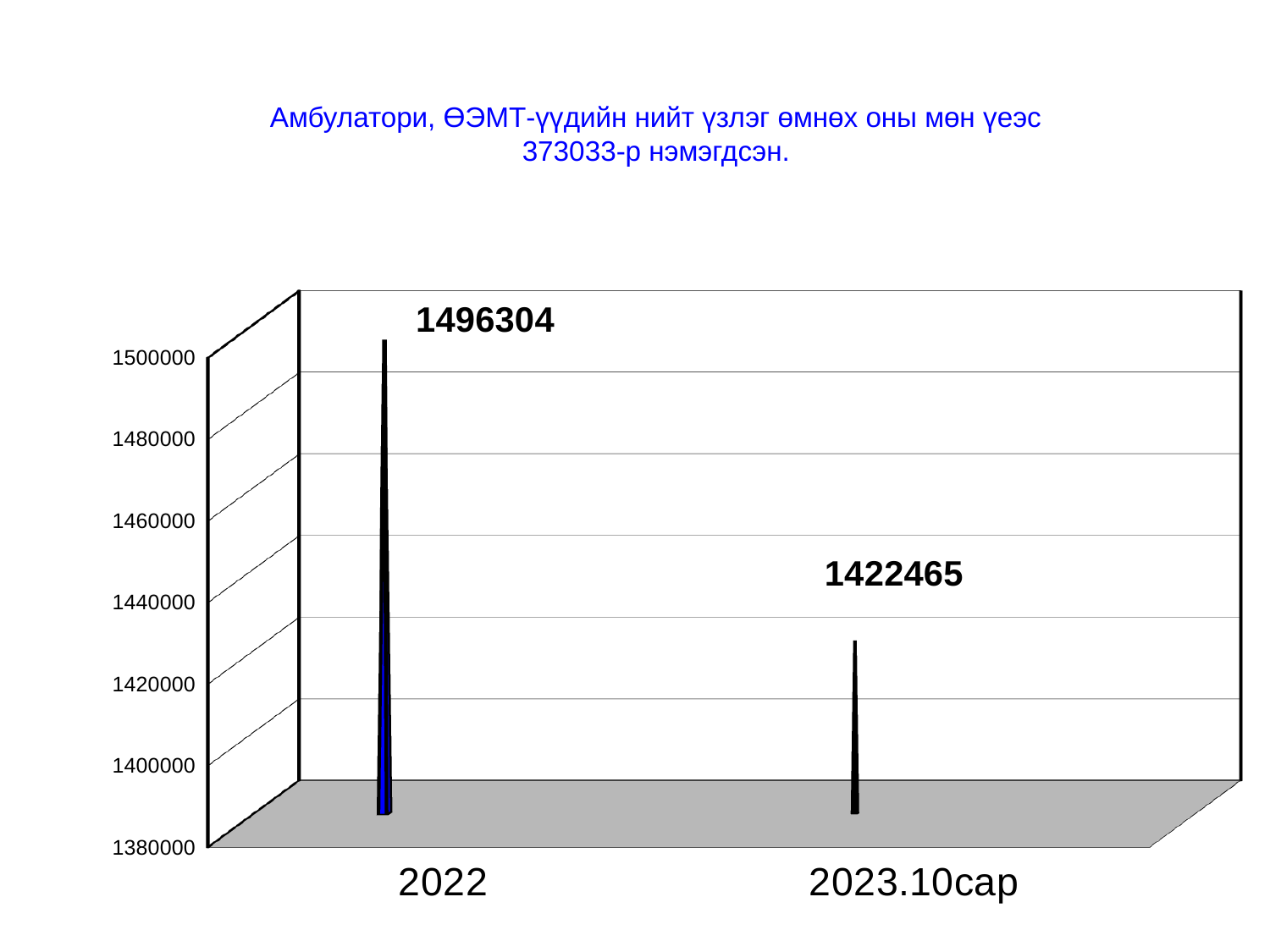
What is the lowest value shown on the vertical axis? 1380000 Do the values rise or fall from 2022 to 2023.10сар? fall Is the value for 2022 greater or less than 1480000? greater What is the value for 2023.10сар? 1422465 How many categories are shown on the x axis? 2 Which category has the lowest value? 2023.10сар Which category has the highest value? 2022 Is the value for 2023.10сар greater or less than 1440000? less What kind of chart is shown on the slide? bar chart What is the difference between the value for 2022 and the value for 2023.10сар? 73839 Which is larger, the value for 2022 or the value for 2023.10сар? 2022 What is the value for 2022? 1496304